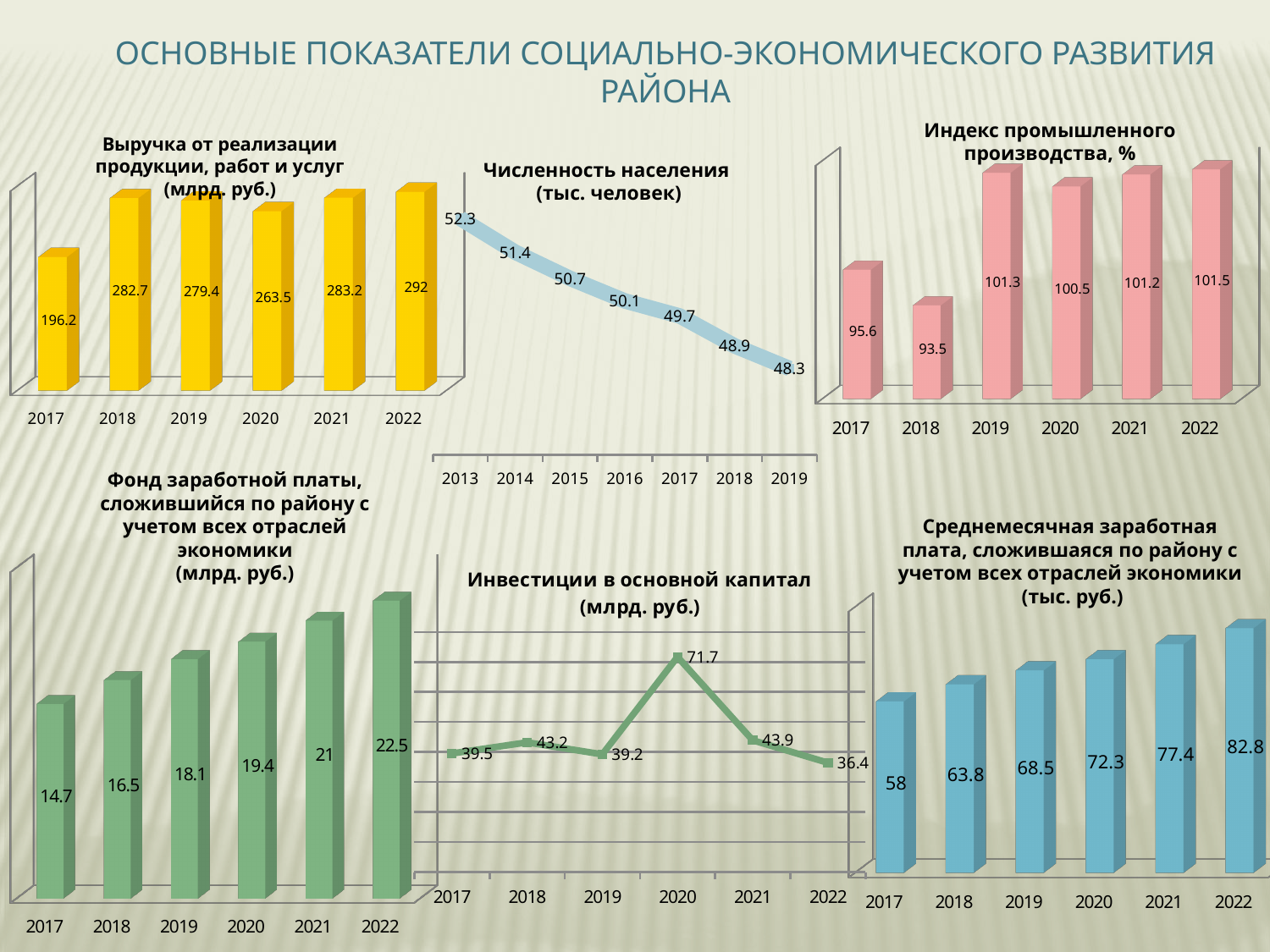
What type of chart is 'Инвестиции в основной капитал (млрд. руб.)'? line chart In the chart 'Среднемесячная заработная плата, сложившаяся по району с учетом всех отраслей экономики (тыс. руб.)', what is the difference between the values for 2022 and 2017? 24.8 In the chart 'Численность населения (тыс. человек)', what is the value for 2019? 48.3 In the chart 'Индекс промышленного производства, %', which year has the lowest value? 2018 In the chart 'Инвестиции в основной капитал (млрд. руб.)', which year has the highest value? 2020 In the chart 'Фонд заработной платы, сложившийся по району с учетом всех отраслей экономики (млрд. руб.)', what is the value for 2021? 21 In the chart 'Численность населения (тыс. человек)', do the values rise or fall from 2013 to 2019? fall In the chart 'Выручка от реализации продукции, работ и услуг (млрд. руб.)', which year has the highest value? 2022 In the chart 'Индекс промышленного производства, %', what is the difference between the values for 2019 and 2017? 5.7 In the chart 'Выручка от реализации продукции, работ и услуг (млрд. руб.)', what is the value for 2017? 196.2 How many data points are plotted in the chart 'Численность населения (тыс. человек)'? 7 In the chart 'Инвестиции в основной капитал (млрд. руб.)', which is larger, the value for 2018 or the value for 2022? 2018